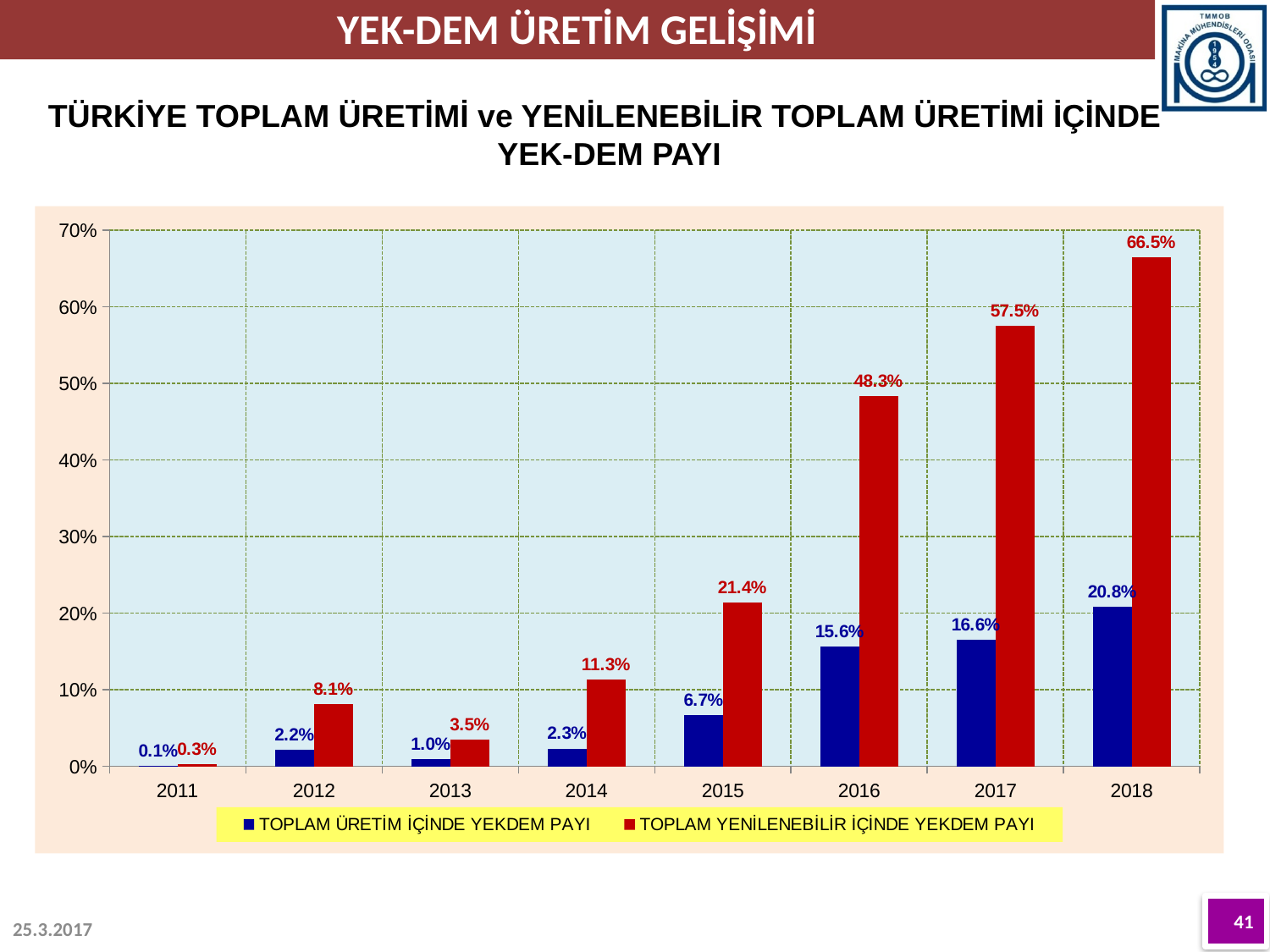
What is the difference between TOPLAM YENİLENEBİLİR İÇİNDE YEKDEM PAYI in 2017 and 2016? 9.2% Does TOPLAM YENİLENEBİLİR İÇİNDE YEKDEM PAYI rise or fall from 2014 to 2018? Rise In which year is TOPLAM ÜRETİM İÇİNDE YEKDEM PAYI lowest? 2011 Is the value of TOPLAM YENİLENEBİLİR İÇİNDE YEKDEM PAYI for 2017 greater or less than 50%? greater In which year is TOPLAM YENİLENEBİLİR İÇİNDE YEKDEM PAYI highest? 2018 How many series does the legend list? 2 How many years are shown on the x axis? 8 What is the value of TOPLAM YENİLENEBİLİR İÇİNDE YEKDEM PAYI for 2018? 66.5% What kind of chart is shown on the slide? Bar chart Which is larger: TOPLAM ÜRETİM İÇİNDE YEKDEM PAYI in 2012 or in 2013? 2012 What is the value of TOPLAM YENİLENEBİLİR İÇİNDE YEKDEM PAYI for 2014? 11.3% What is the value of TOPLAM ÜRETİM İÇİNDE YEKDEM PAYI for 2016? 15.6%